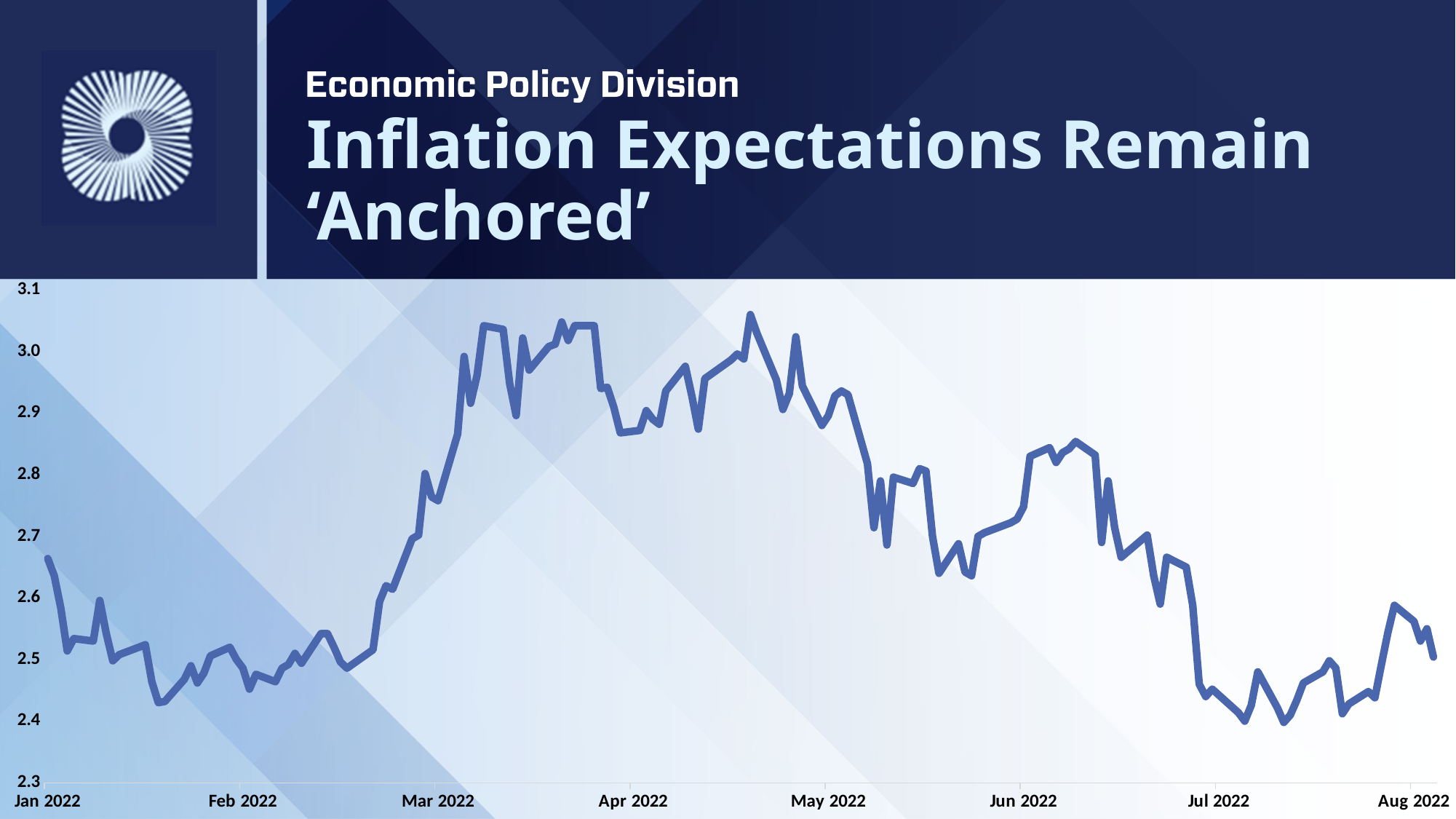
Is the value at Jun 2022 greater or less than 2.7? greater What kind of chart is shown on the slide? line chart Does the line generally rise or fall between Mar 2022 and Apr 2022? rise Is the highest point reached by the line greater or less than 3.0? greater What is the highest value shown on the y axis of the chart? 3.1 Is the value at Apr 2022 greater or less than 2.8? greater What is the lowest value shown on the y axis of the chart? 2.3 How many month labels are shown along the x axis of the chart? 8 How many lines (data series) are plotted on the chart? 1 Does the line generally rise or fall between Jun 2022 and Jul 2022? fall